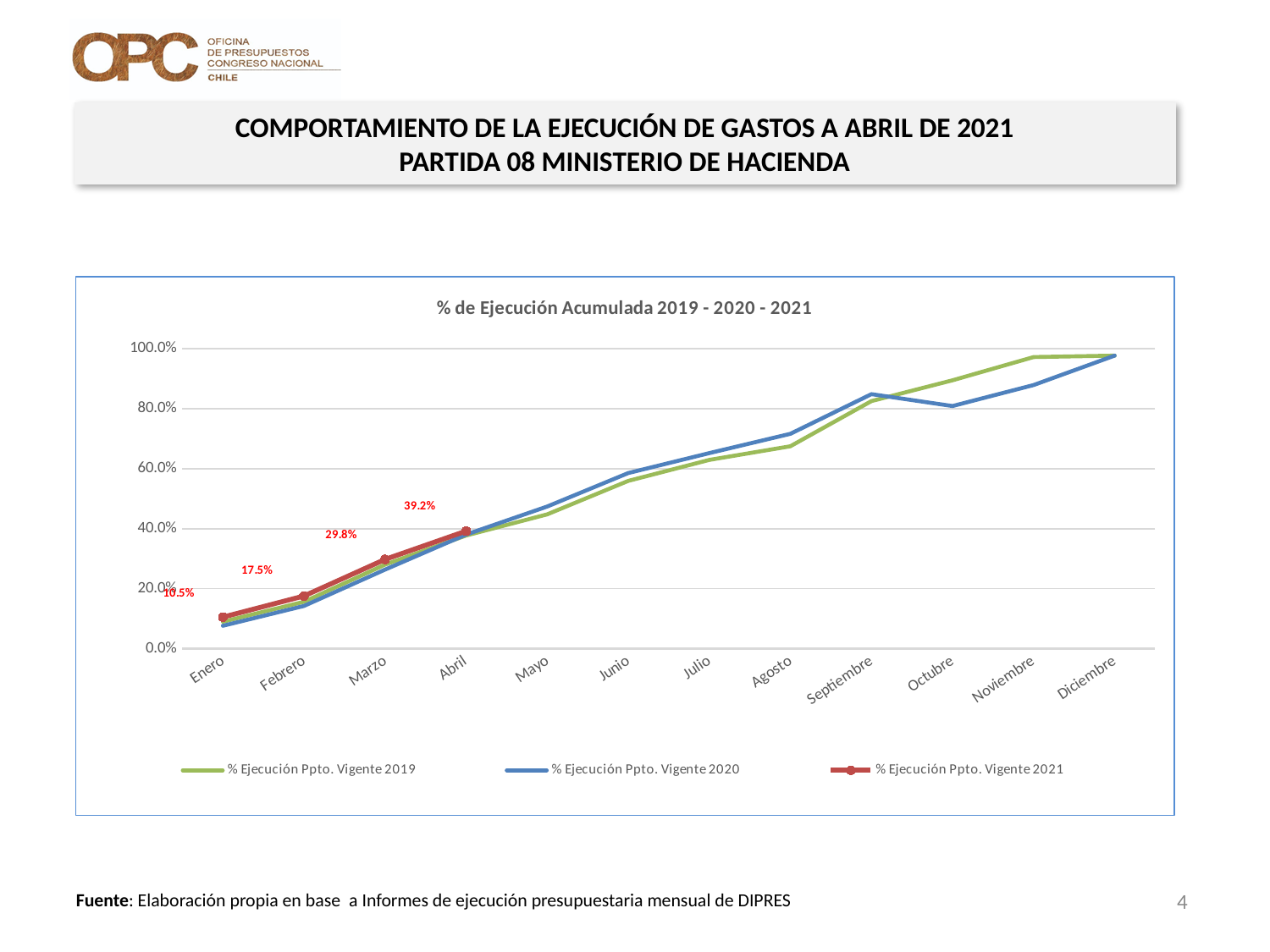
What is the difference between the 2021 values for Abril and Marzo? 9.4% How many months are shown on the x axis? 12 How many series does the legend list? 3 What kind of chart is shown on the slide? line chart Does the % Ejecución Ppto. Vigente 2021 series rise or fall from Enero to Abril? rise In Octubre, which series has the larger value: % Ejecución Ppto. Vigente 2019 or % Ejecución Ppto. Vigente 2020? % Ejecución Ppto. Vigente 2019 What is the title of the chart? % de Ejecución Acumulada 2019 - 2020 - 2021 What is the value of % Ejecución Ppto. Vigente 2021 for Abril? 39.2% What is the value of % Ejecución Ppto. Vigente 2021 for Enero? 10.5% Is the value for % Ejecución Ppto. Vigente 2020 in Agosto greater or less than 60.0%? greater What is the difference between the 2021 values for Febrero and Enero? 7.0% What is the value of % Ejecución Ppto. Vigente 2021 for Marzo? 29.8%